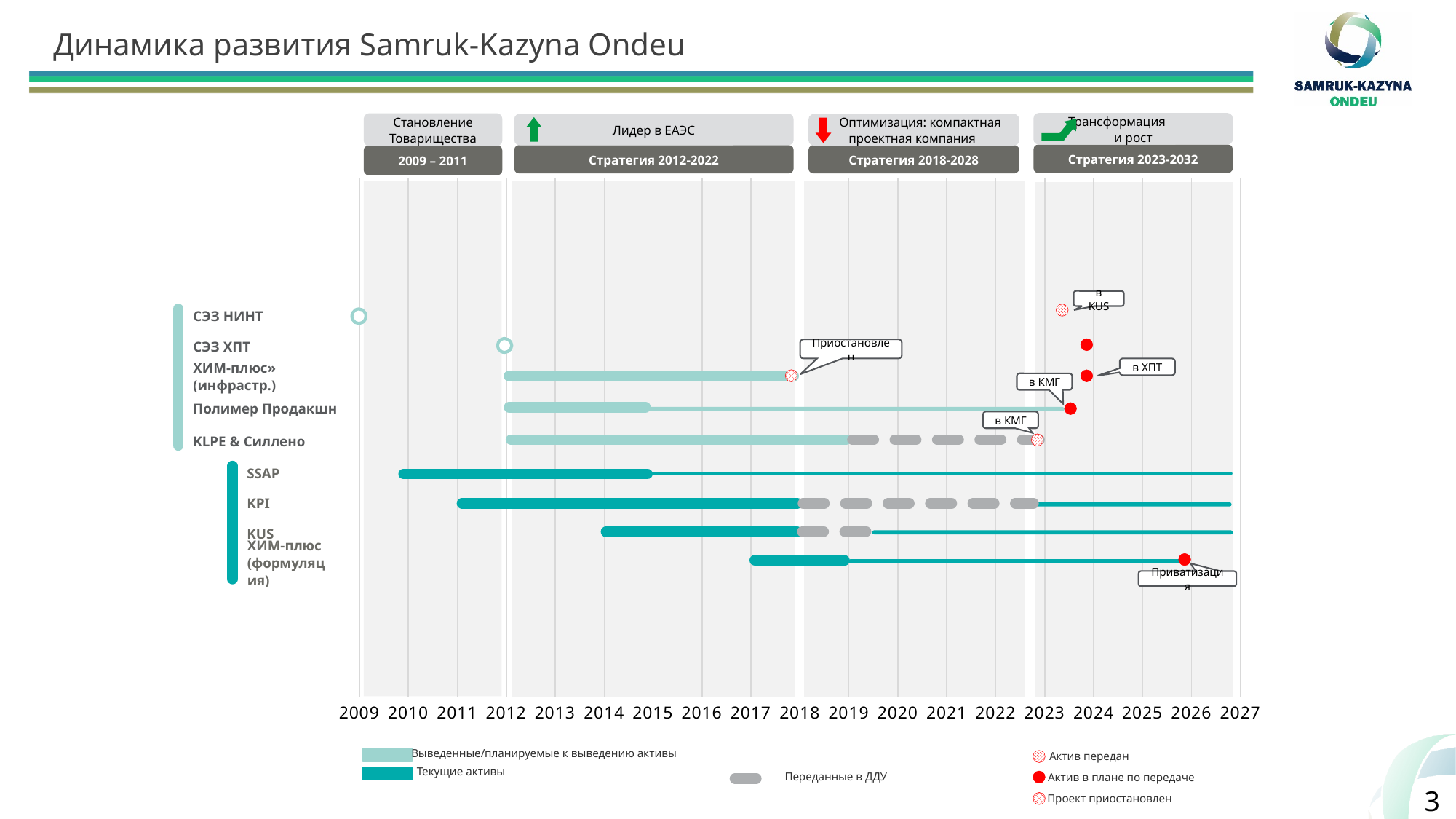
In which year does the ХИМ-плюс (формуляция) bar begin? 2017 What does the callout at the end of the ХИМ-плюс (инфрастр.) bar in 2018 say? Приостановлен How many asset rows are listed on the left of the timeline? 9 What is the first year shown on the x axis? 2009 In which year does the KUS bar begin? 2014 What kind of chart is shown on the slide? Timeline (Gantt) chart What does the callout at the 2026 marker on the ХИМ-плюс (формуляция) row say? Приватизация In which year does the KPI bar begin? 2011 Which starts earlier on the timeline, the SSAP bar or the KPI bar? SSAP How many strategy periods are shown above the timeline? 4 In which year does the SSAP bar begin? 2010 What is the last year shown on the x axis? 2027